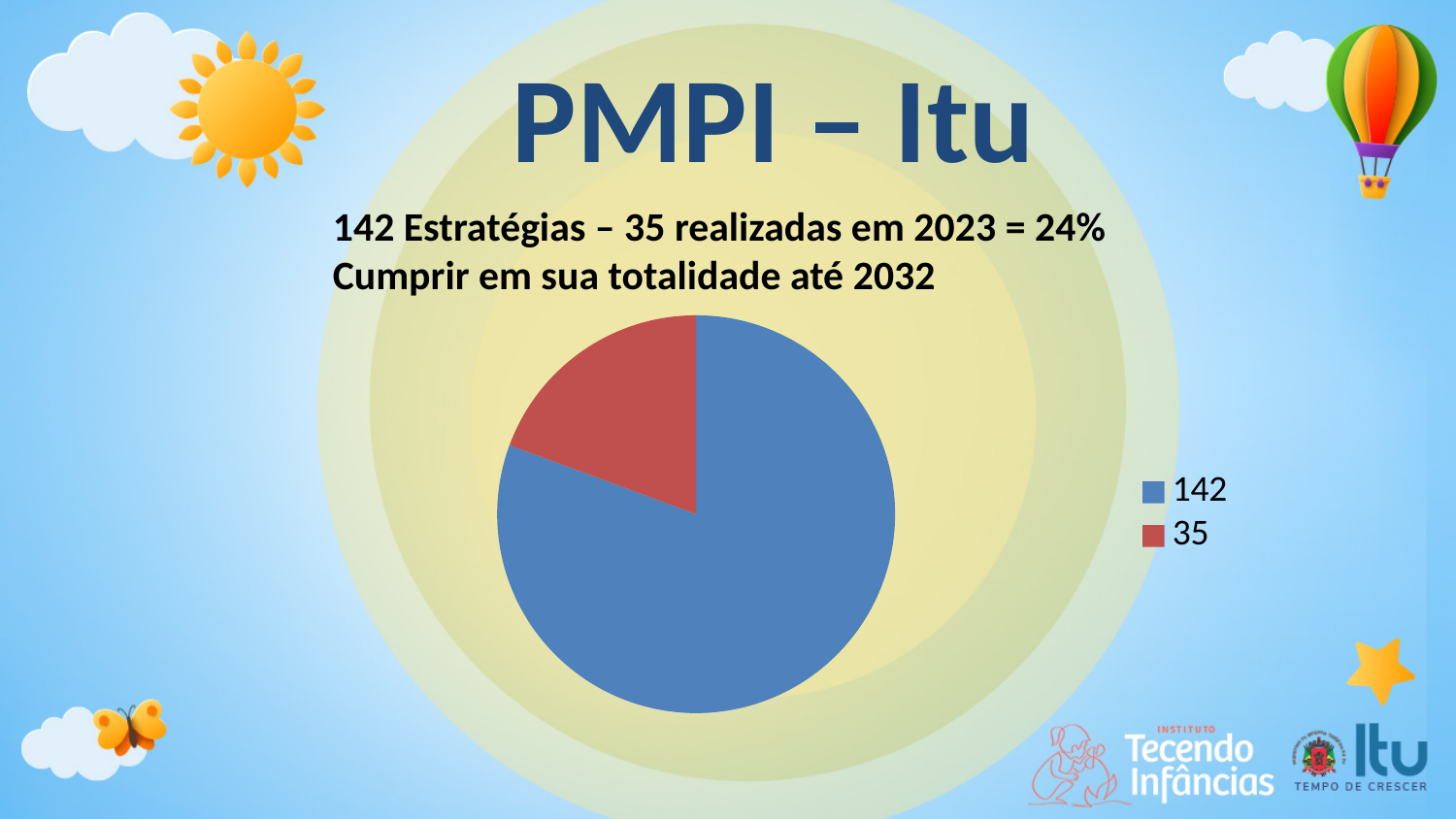
What kind of chart is shown on the slide? pie chart What colour is the slice labelled 142 in the pie chart? blue How many entries does the legend of the pie chart list? 2 Which legend entry corresponds to the largest slice of the pie chart? 142 Which slice is larger in the pie chart, the one labelled 142 or the one labelled 35? 142 Which legend entry corresponds to the smallest slice of the pie chart? 35 What colour is the slice labelled 35 in the pie chart? red How many slices does the pie chart have? 2